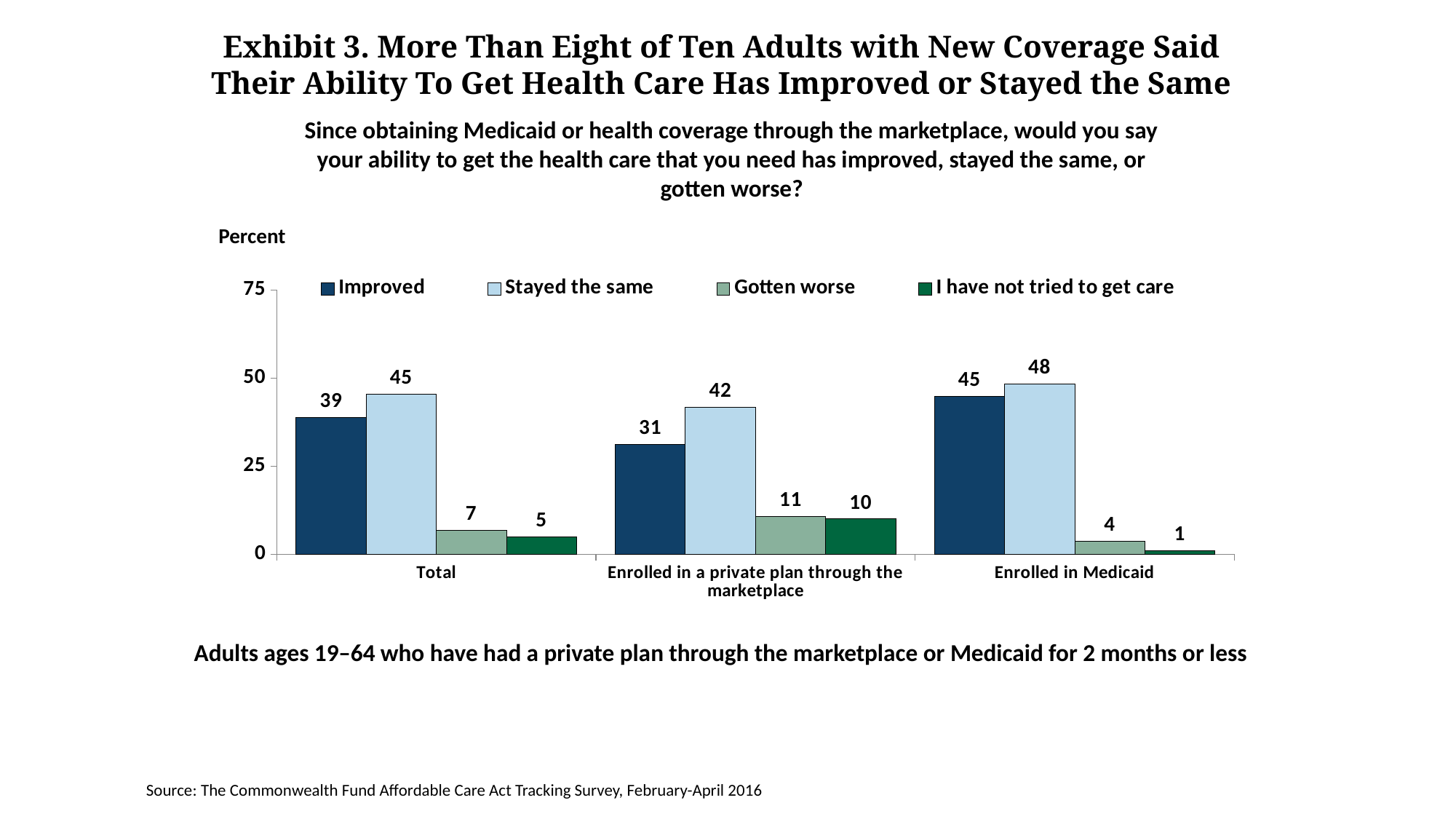
What percent of adults in the Total group said their ability to get care has improved? 39 What is the difference between 'Stayed the same' and 'Improved' for the Total group? 6 What kind of chart is shown on the slide? Bar chart Which group has the highest value for 'Improved'? Enrolled in Medicaid How many series does the legend list? 4 What is the value for 'I have not tried to get care' among adults enrolled in Medicaid? 1 What percent of adults enrolled in a private plan through the marketplace said their ability to get care has gotten worse? 11 Which group has the lowest value for 'Gotten worse'? Enrolled in Medicaid What is the label on the y axis? Percent What is the value for 'Stayed the same' among adults enrolled in Medicaid? 48 Is the 'Improved' value larger for adults enrolled in Medicaid or for adults enrolled in a private plan through the marketplace? Enrolled in Medicaid How many groups are shown on the x axis? 3